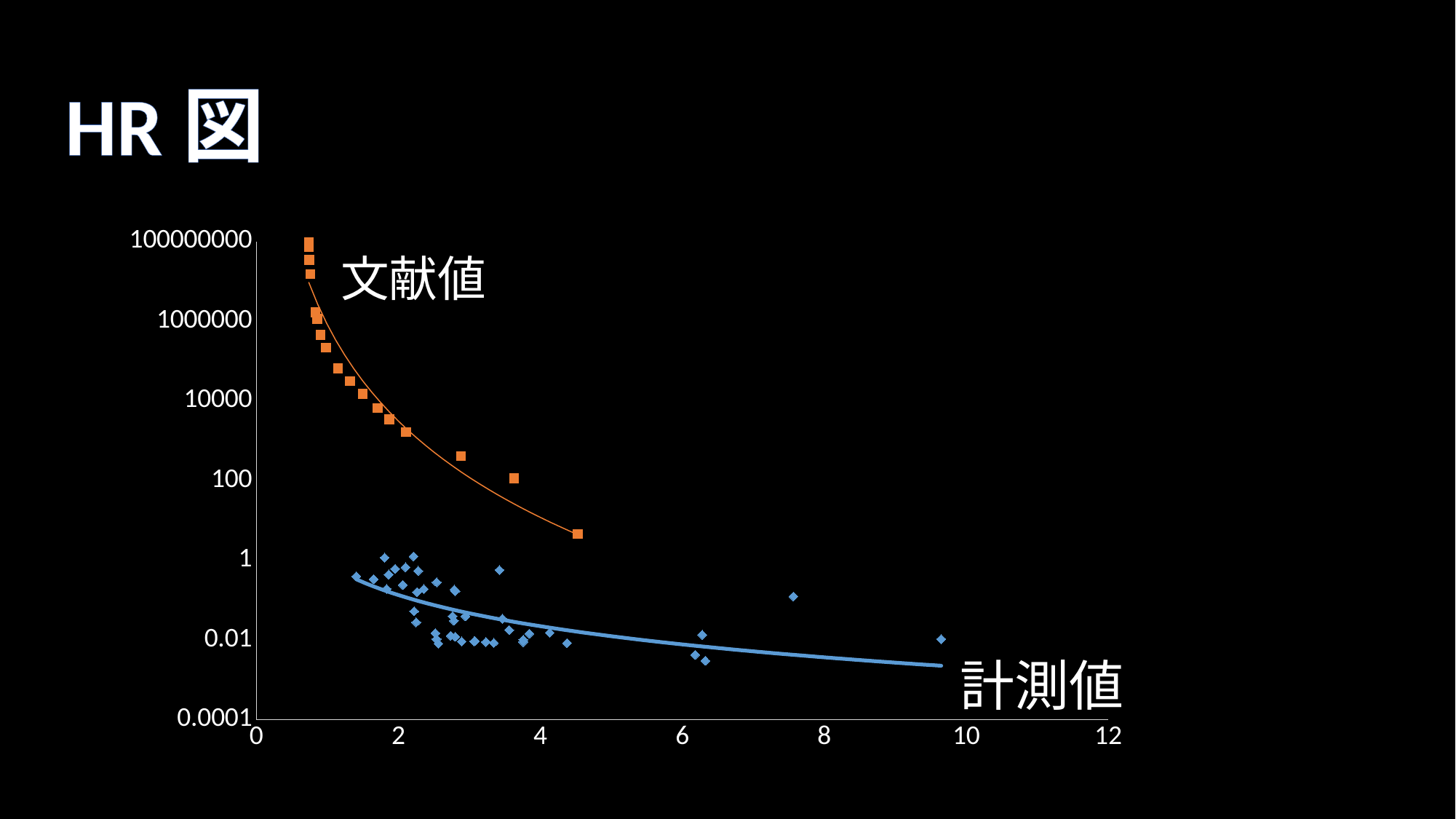
What kind of chart is shown on the slide? scatter chart Are the 計測値 values near x = 6 greater or less than 1? less What colour are the 計測値 markers? blue Do the 計測値 values generally rise or fall as the x value increases? fall How many data series are plotted on the chart? 2 Which series has the higher y values, 文献値 or 計測値? 文献値 What is the title of the chart on the slide? HR 図 Are the 文献値 values near x = 1 greater or less than 100? greater Which series extends to larger x values, 文献値 or 計測値? 計測値 Do the 文献値 values rise or fall as the x value increases? fall Are the 文献値 values near x = 2 greater or less than 100? greater